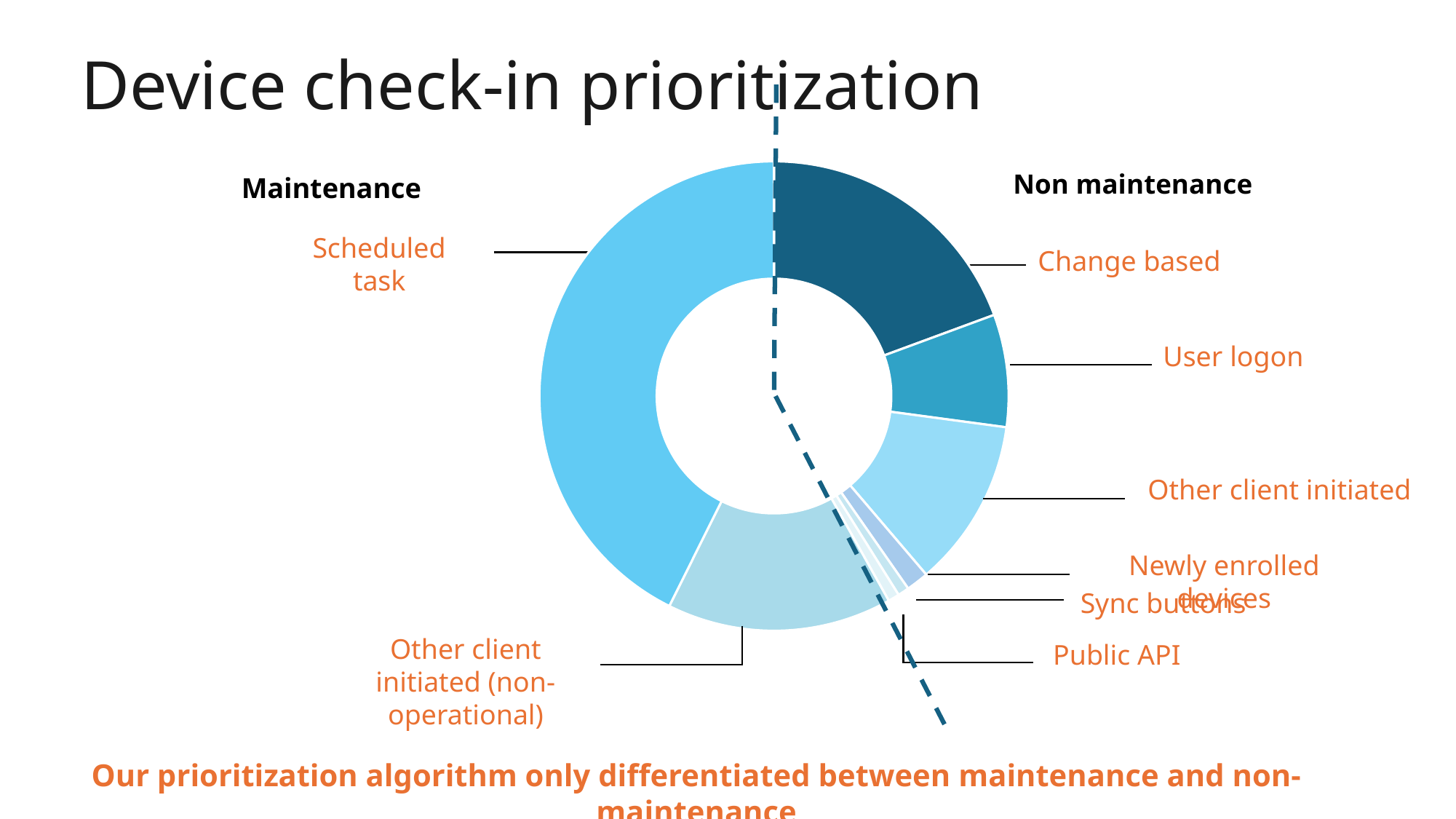
Which slice is larger, Scheduled task or Other client initiated (non-operational)? Scheduled task Which slice is larger, Other client initiated or Sync buttons? Other client initiated Which slice is larger, Scheduled task or Change based? Scheduled task Which category has the largest slice in the donut chart? Scheduled task How many slices does the donut chart have? 8 What is the title of the slide containing the chart? Device check-in prioritization What kind of chart is shown on the slide? Donut (pie) chart What are the two groups the dashed line divides the donut chart into? Maintenance and Non maintenance